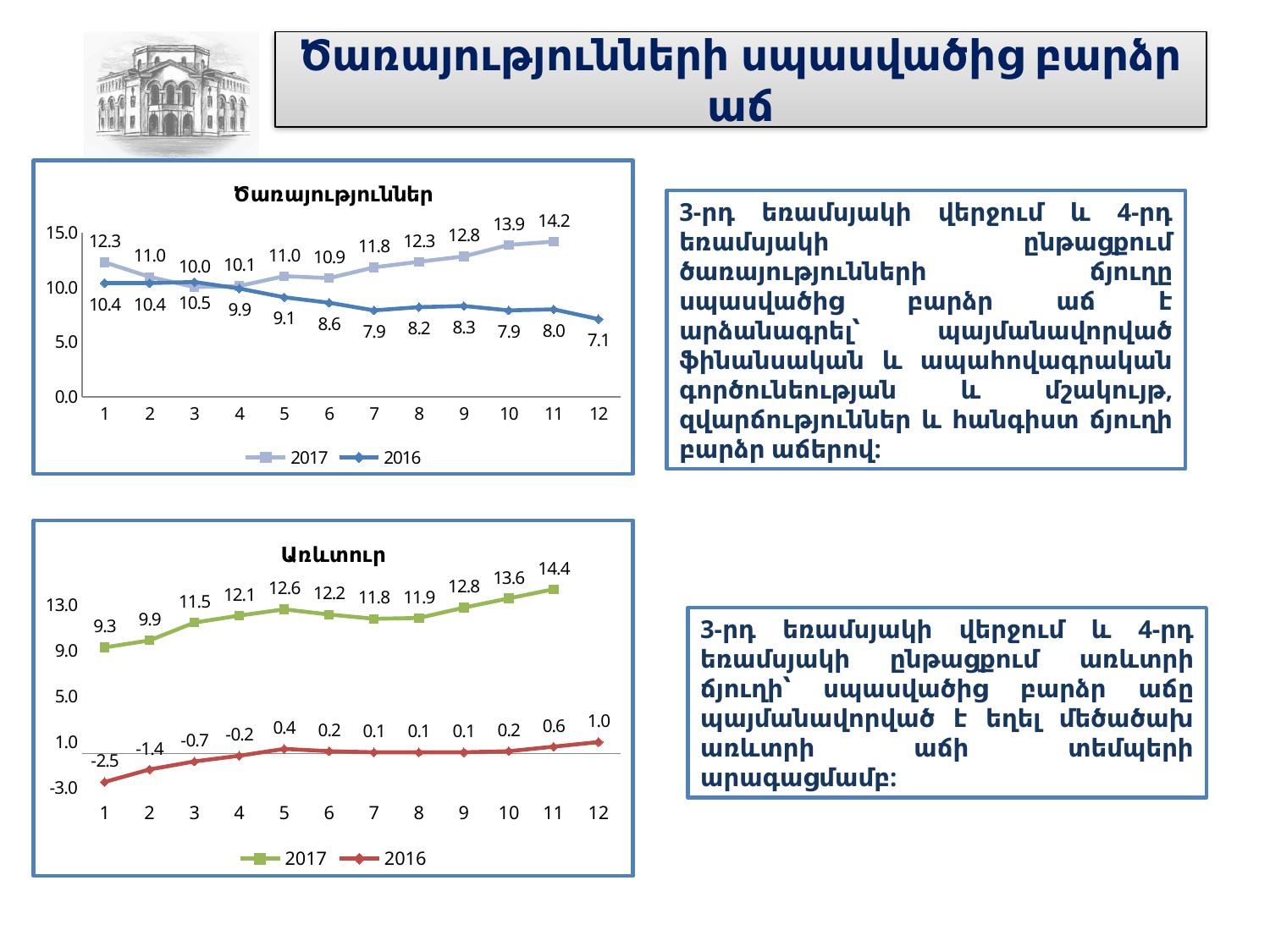
In the top chart (Ծառայություններ), which point has the lowest 2016 value? 12 In the bottom chart (Առևտուր), how many points are plotted for the 2016 series? 12 In the bottom chart (Առևտուր), which point has the highest 2017 value? 11 In the bottom chart (Առևտուր), what is the difference between the 2017 value at point 11 and the 2017 value at point 1? 5.1 In the top chart (Ծառայություններ), what is the difference between the 2017 and 2016 values at point 10? 6.0 In the top chart (Ծառայություններ), how many series does the legend list? 2 In the bottom chart (Առևտուր), what is the 2016 value at point 1? -2.5 In the top chart (Ծառայություններ), what is the 2016 value at point 12? 7.1 What kind of chart is the bottom chart (Առևտուր)? Line chart In the bottom chart (Առևտուր), does the 2016 series generally rise or fall from point 1 to point 12? Rise In the top chart (Ծառայություններ), what is the 2017 value at point 11? 14.2 In the top chart (Ծառայություններ), which series has the larger value at point 8, 2017 or 2016? 2017